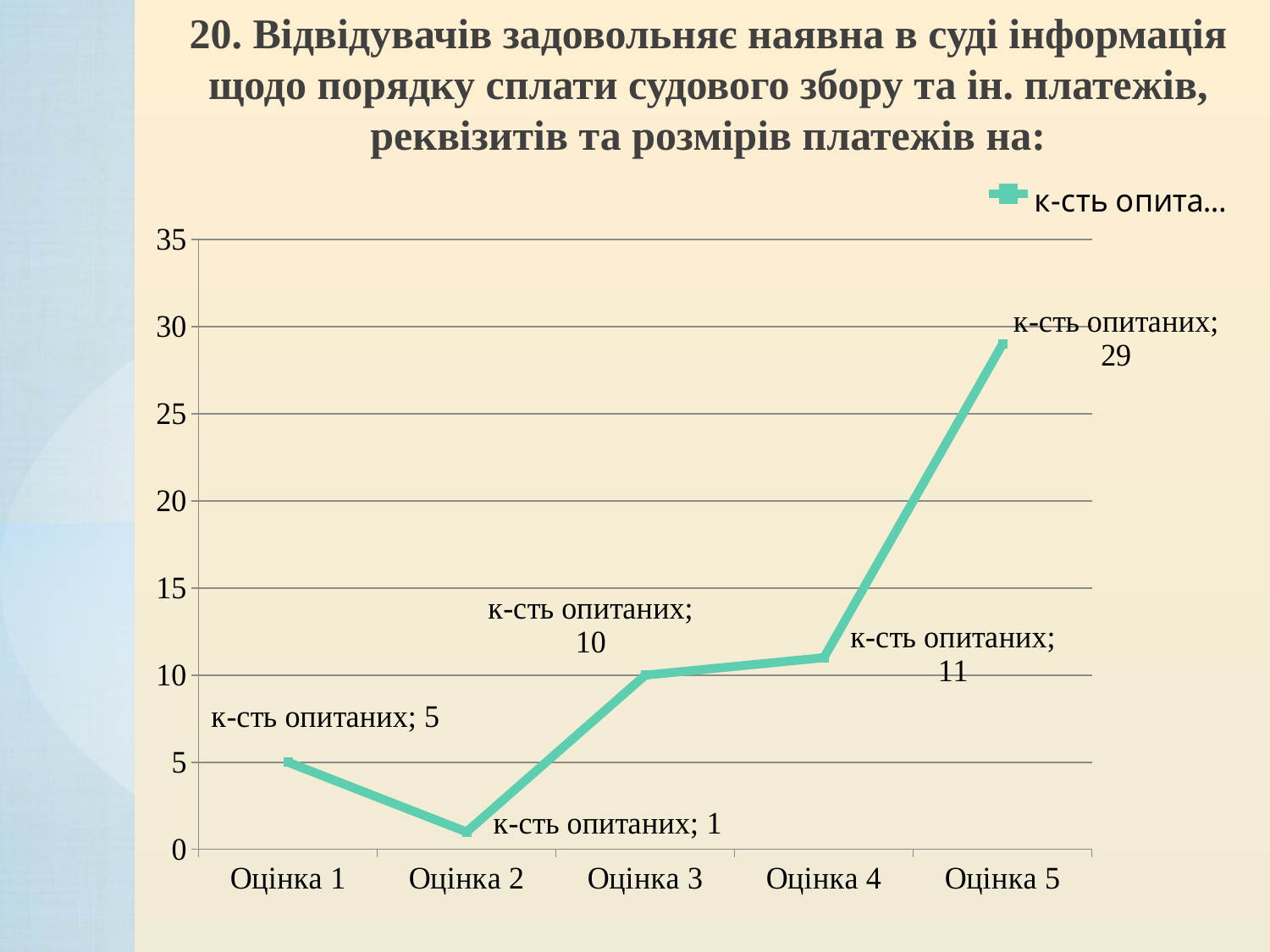
Do the values rise or fall from Оцінка 2 to Оцінка 5? rise What is the value for Оцінка 2? 1 What is the difference between the values for Оцінка 5 and Оцінка 4? 18 What is the value for Оцінка 4? 11 What is the value for Оцінка 5? 29 What is the value for Оцінка 3? 10 Which category has the highest value? Оцінка 5 Which is larger, the value for Оцінка 1 or the value for Оцінка 3? Оцінка 3 What is the value for Оцінка 1? 5 Which category has the lowest value? Оцінка 2 How many categories are shown on the x axis? 5 What kind of chart is shown on the slide? line chart